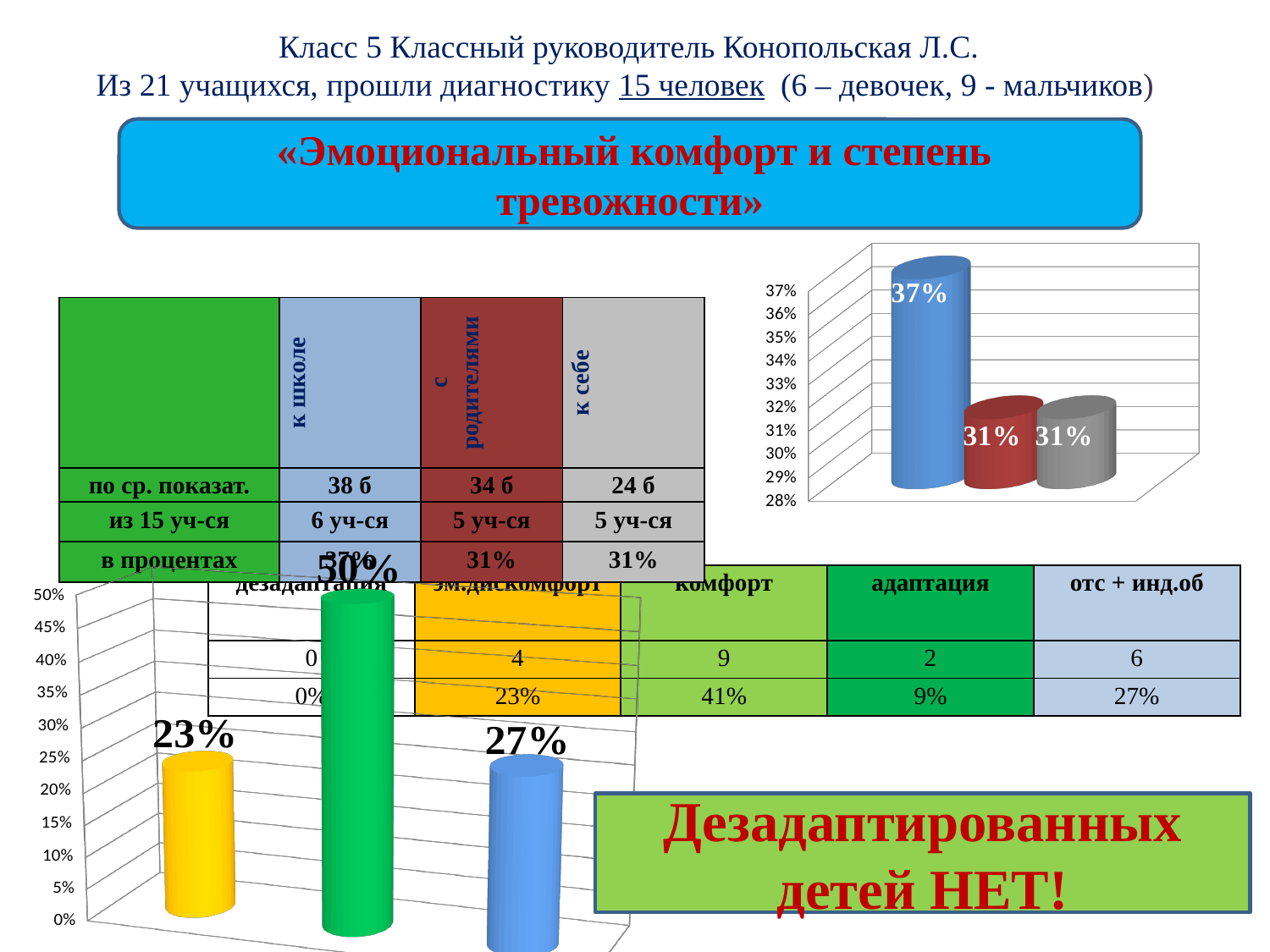
On the chart in the top right of the slide, what is the difference between the blue bar (37%) and the red bar (31%)? 6% On the chart in the bottom left of the slide, what is the difference between the green bar (50%) and the blue bar (27%)? 23% On the chart in the top right of the slide, what value is labelled on the red bar? 31% On the chart in the top right of the slide, what value is labelled on the tallest (blue) bar? 37% On the chart in the bottom left of the slide, what value is labelled on the green bar? 50% On the chart in the bottom left of the slide, which is larger: the blue bar or the yellow bar? the blue bar (27%) On the chart in the top right of the slide, is the value of the blue bar greater or less than 35%? greater What kind of chart is shown in the top right of the slide? bar chart On the chart in the bottom left of the slide, what value is labelled on the yellow bar? 23% On the chart in the top right of the slide, how many bars are plotted? 3 On the chart in the bottom left of the slide, how many bars are plotted? 3 On the chart in the bottom left of the slide, which bar has the lowest value? the yellow bar (23%)